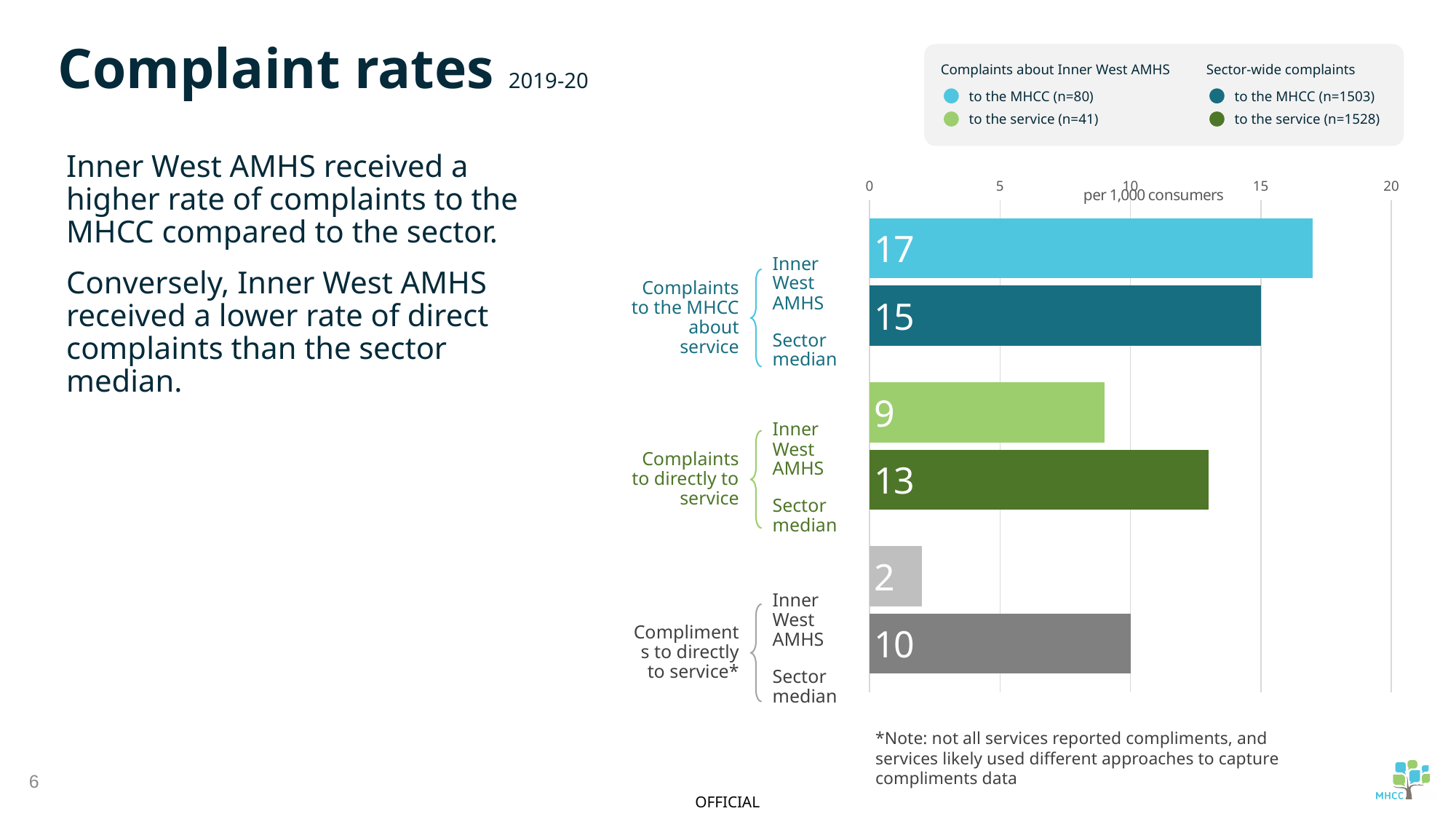
What is the sector median rate of complaints to the MHCC about service? 15 What is the rate of complaints to the MHCC about service for Inner West AMHS? 17 What is the sector median rate of compliments made directly to service? 10 How many bars are plotted on the chart? 6 What unit is shown on the chart's axis? per 1,000 consumers What is the rate of complaints made directly to service for Inner West AMHS? 9 What is the difference between Inner West AMHS and the sector median for compliments made directly to service? 8 Which bar has the highest value on the chart? Inner West AMHS, complaints to the MHCC about service For complaints to the MHCC about service, which is larger: Inner West AMHS or the sector median? Inner West AMHS Which bar has the lowest value on the chart? Inner West AMHS, compliments to directly to service What is the difference between the sector median and Inner West AMHS for complaints made directly to service? 4 What kind of chart is shown on the slide? Bar chart